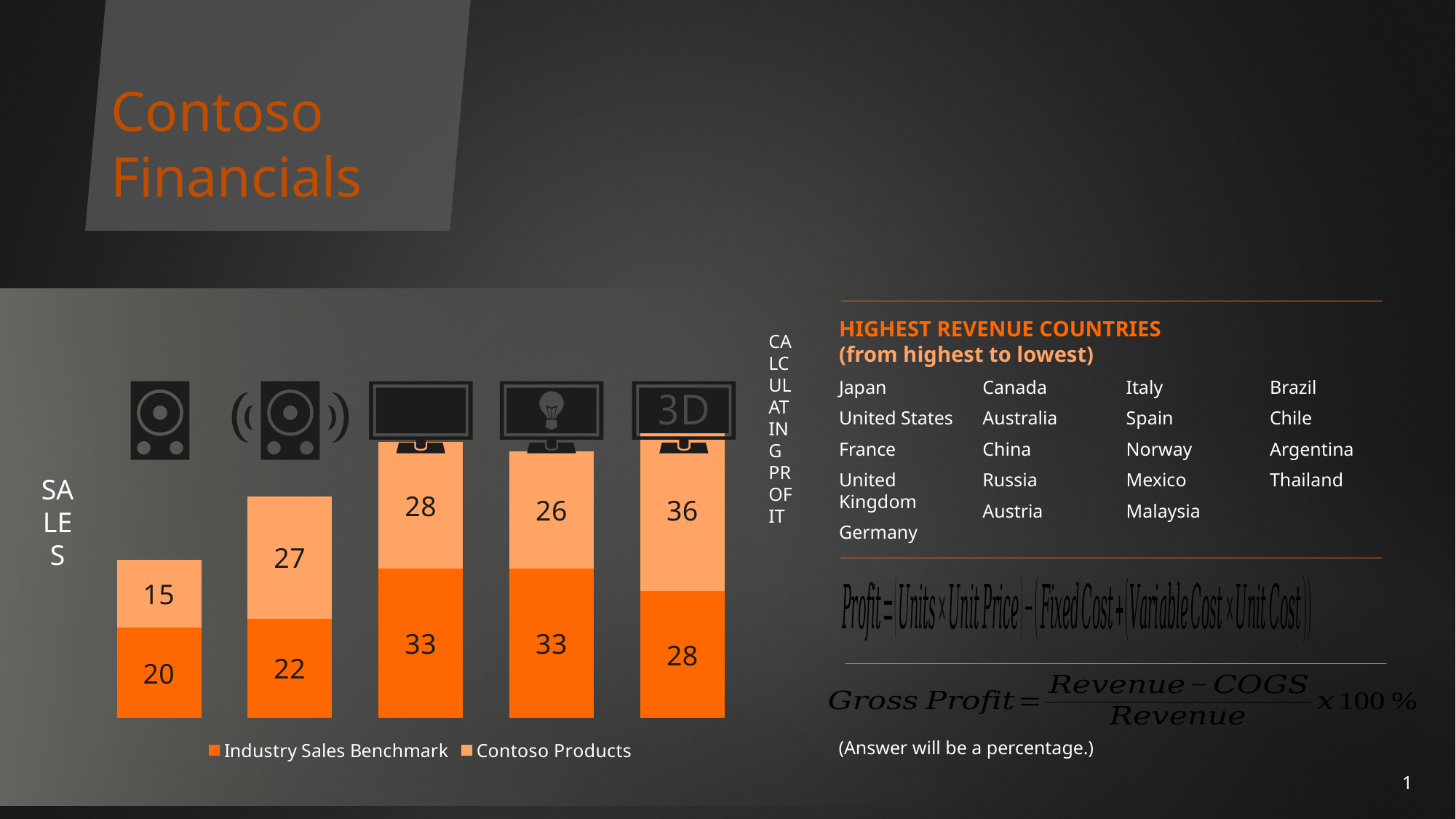
What kind of chart is shown on the left of the slide? stacked bar chart What are the two series names listed in the chart legend? Industry Sales Benchmark and Contoso Products What is the difference between the Contoso Products value and the Industry Sales Benchmark value in the fifth bar from the left? 8 Which bar has the lowest Industry Sales Benchmark value? the first bar (speaker icon) What is the Contoso Products value for the bar with the 3D icon (fifth from the left)? 36 What is the total of the stacked bar for the third category from the left? 61 How many bars (categories) are plotted in the chart? 5 Which bar has the highest Contoso Products value? the fifth bar (3D icon) In the first bar from the left, which is larger: the Industry Sales Benchmark value or the Contoso Products value? Industry Sales Benchmark What is the Contoso Products value for the second bar from the left? 27 What is the Industry Sales Benchmark value for the first bar from the left? 20 How many series does the chart legend list? 2